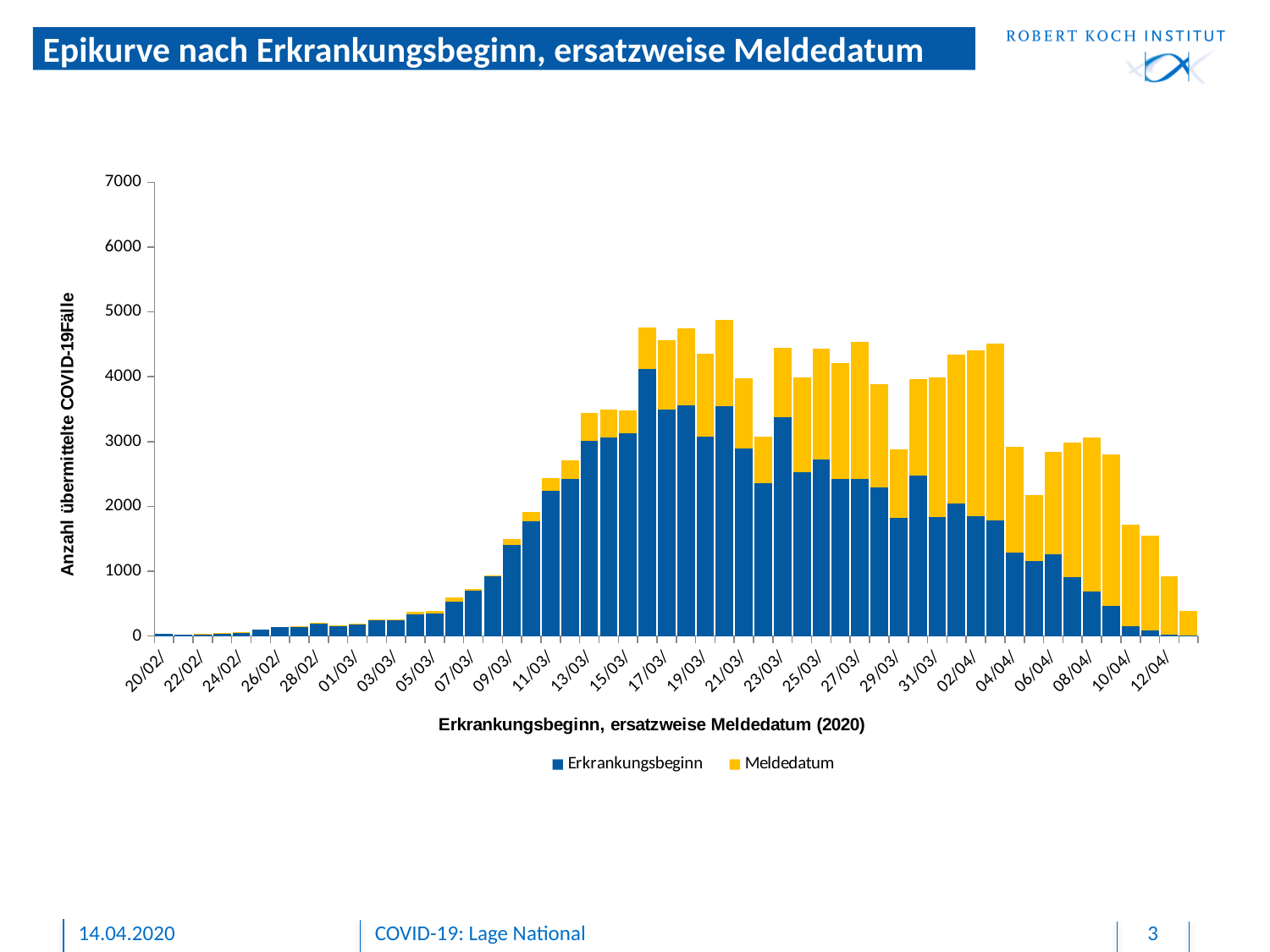
How many series does the legend list? 2 What are the two series named in the legend? Erkrankungsbeginn and Meldedatum Is the total value of the bar for 11/03 greater or less than 2000? greater What kind of chart is shown on the slide? Stacked bar chart Is the total value of the bar for 10/04 greater or less than 2000? less Which date has the highest Erkrankungsbeginn (blue) value? 16/03 Is the total value of the bar for 17/03 greater or less than 4000? greater What is the title of the vertical axis? Anzahl übermittelte COVID-19Fälle Which bar has the larger total value, 17/03 or 12/04? 17/03